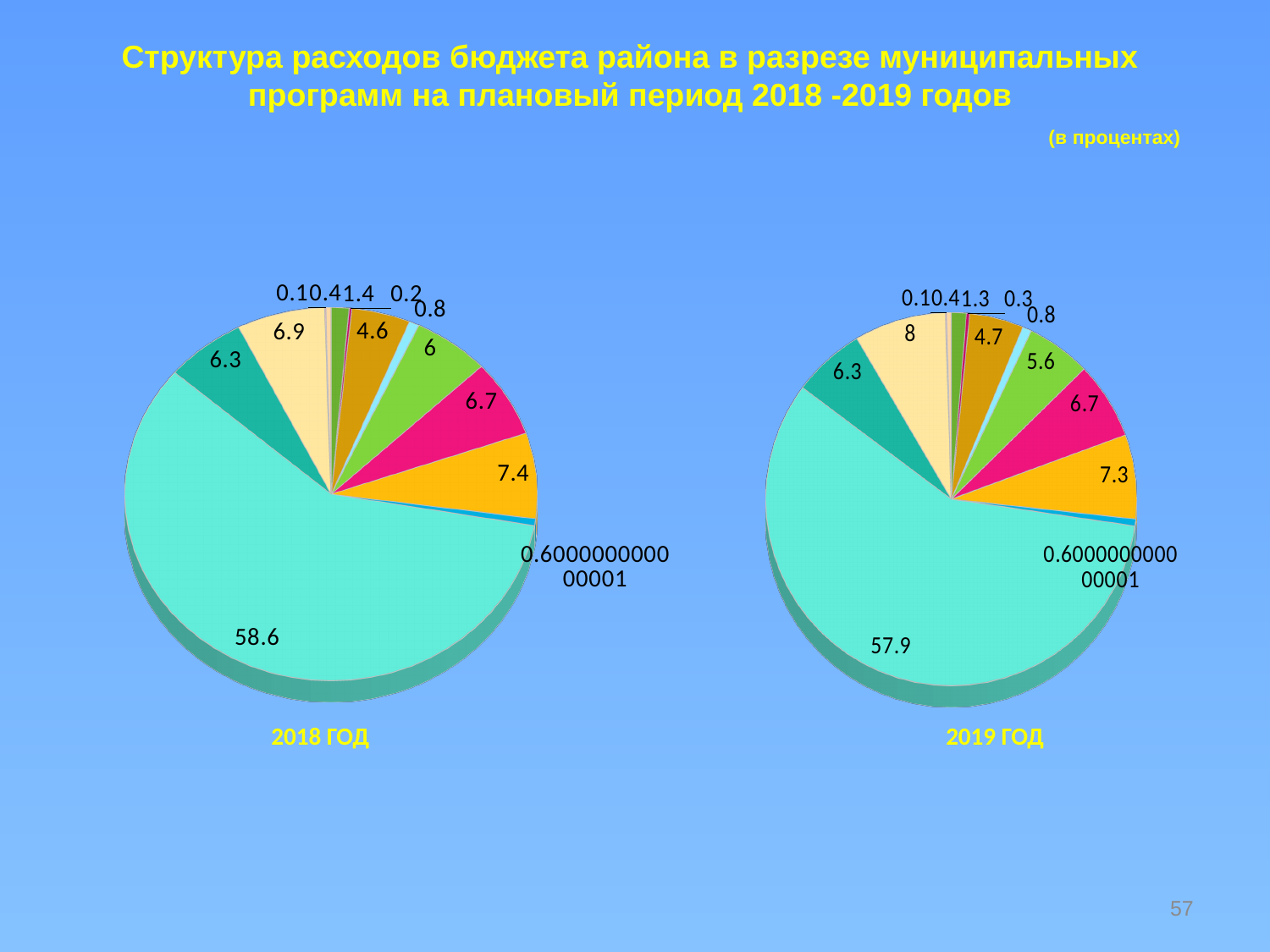
In the 2019 ГОД pie chart, what is the value of the largest slice? 57.9 How many slices does the 2018 ГОД pie chart have? 13 How many slices does the 2019 ГОД pie chart have? 13 In the 2018 ГОД pie chart, what is the value of the largest slice? 58.6 In the 2019 ГОД pie chart, what is the value of the pale yellow slice? 8 In the 2018 ГОД pie chart, what is the value of the smallest labelled slice? 0.1 What kind of chart is used for the 2018 ГОД data? pie chart What unit is stated for the values on the slide? в процентах Which is larger: the largest slice in the 2018 ГОД chart or the largest slice in the 2019 ГОД chart? 2018 ГОД (58.6) What is the difference between the largest slice in the 2018 ГОД chart (58.6) and the largest slice in the 2019 ГОД chart (57.9)? 0.7 In the 2018 ГОД pie chart, what is the value of the magenta (pink) slice? 6.7 In the 2019 ГОД pie chart, what is the value of the orange slice? 7.3